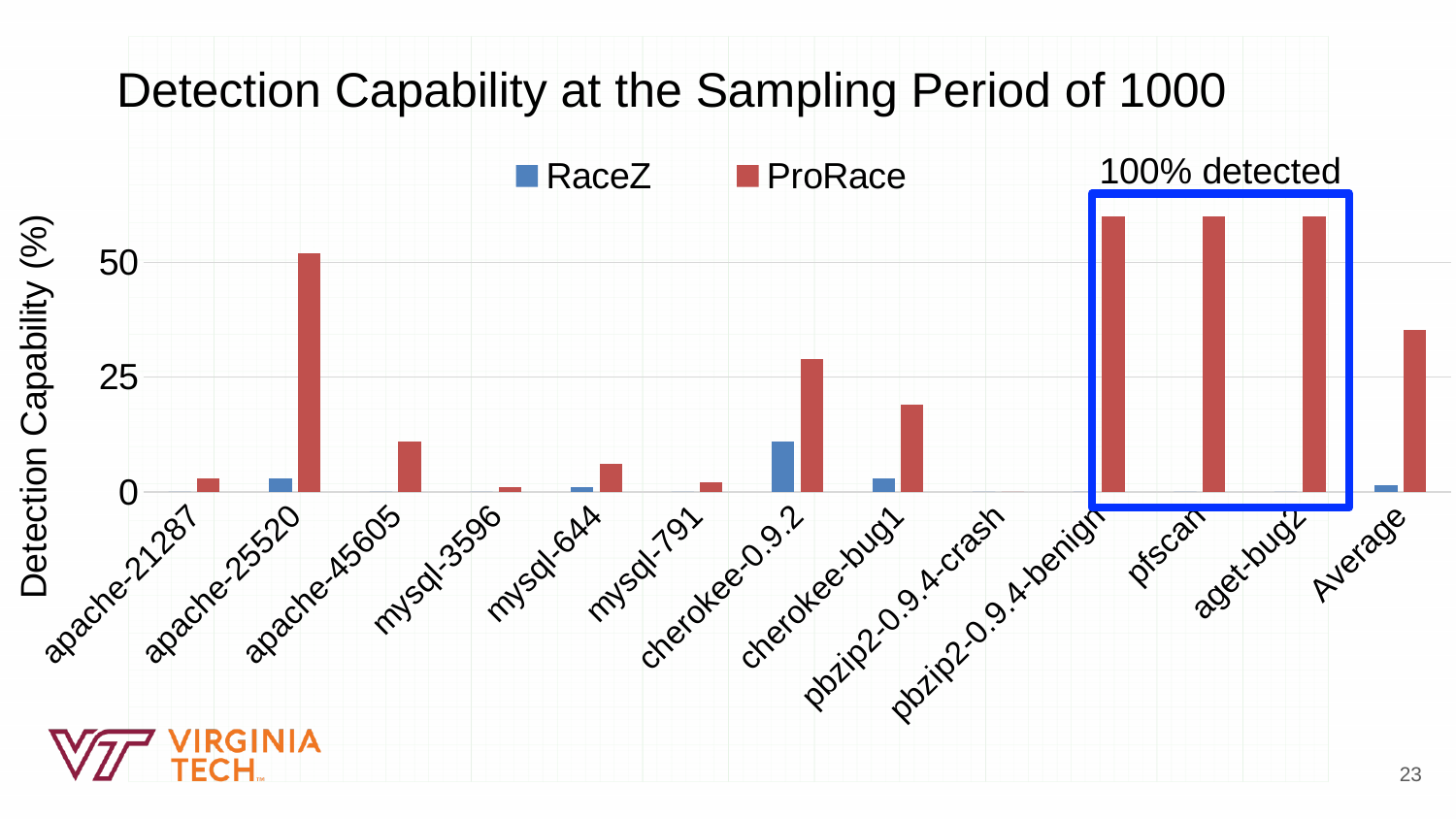
How many series does the legend list? 2 What kind of chart is shown on the slide? bar chart Which series has the highest value for cherokee-0.9.2, RaceZ or ProRace? ProRace How many categories are shown along the x axis? 13 Is the ProRace value for apache-45605 greater or less than 25? less What does the annotation above the blue box around pbzip2-0.9.4-benign, pfscan and aget-bug2 say? 100% detected Is the ProRace value for Average greater or less than 25? greater For which category is the RaceZ bar the highest? cherokee-0.9.2 Is the ProRace value for cherokee-bug1 greater or less than 25? less What is the title of the chart? Detection Capability at the Sampling Period of 1000 Which is larger, the ProRace value for apache-25520 or the ProRace value for cherokee-0.9.2? apache-25520